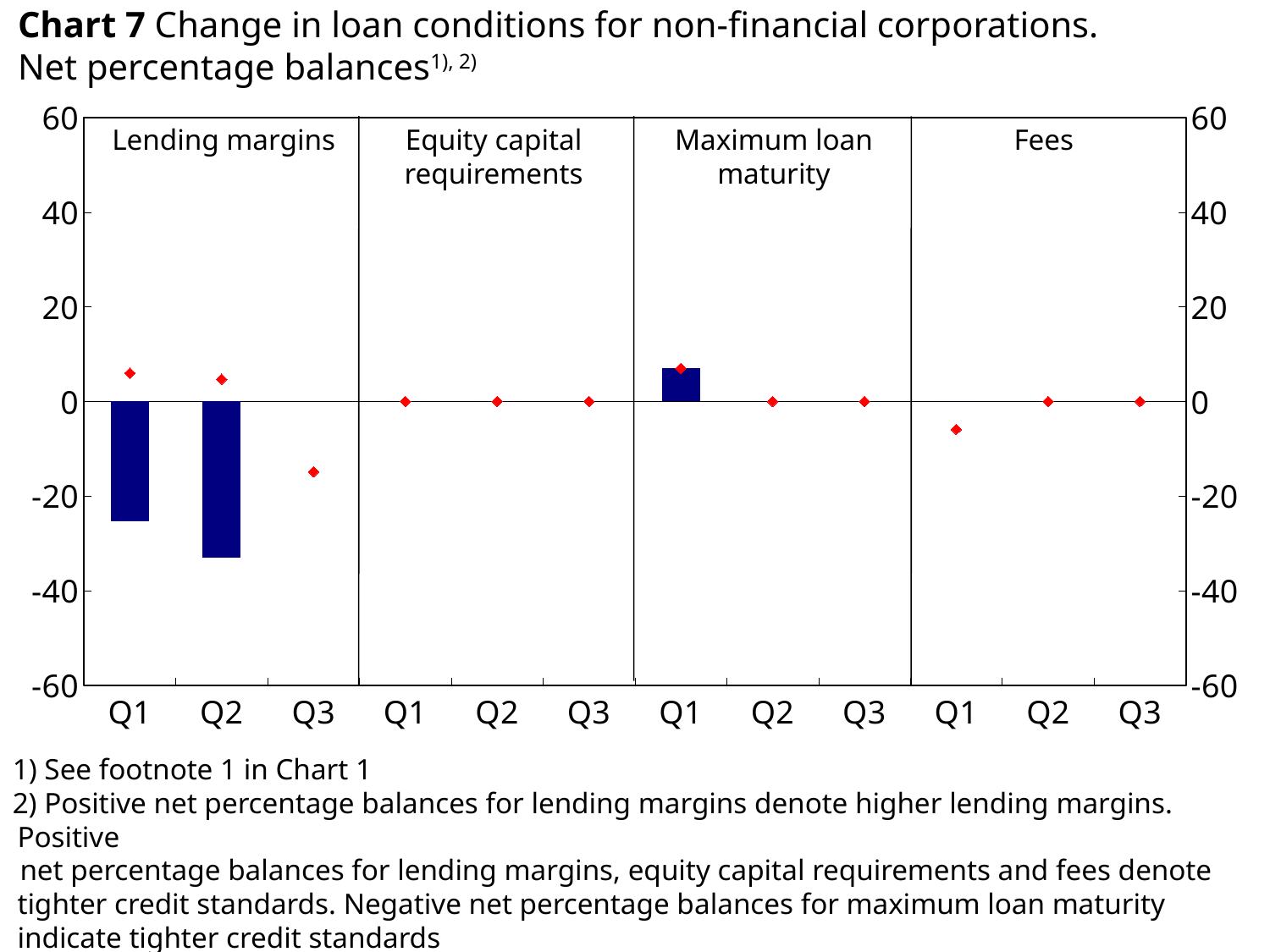
In the Lending margins panel, is the bar for Q1 greater or less than 0? less How many panels (loan condition categories) does the chart have? 4 Which panel contains the only positive bar in the chart? Maximum loan maturity How many quarters are shown on the x axis of each panel? 3 In the Lending margins panel, is the bar for Q2 greater or less than -20? less In the Lending margins panel, do the bars rise or fall from Q1 to Q2? fall In the Maximum loan maturity panel, is the bar for Q1 greater or less than 20? less In the Lending margins panel, which quarter has the lower (more negative) bar, Q1 or Q2? Q2 What are the titles of the four panels in the chart? Lending margins, Equity capital requirements, Maximum loan maturity, Fees What kind of chart is shown on the slide? combination bar and line chart (bars with diamond markers)